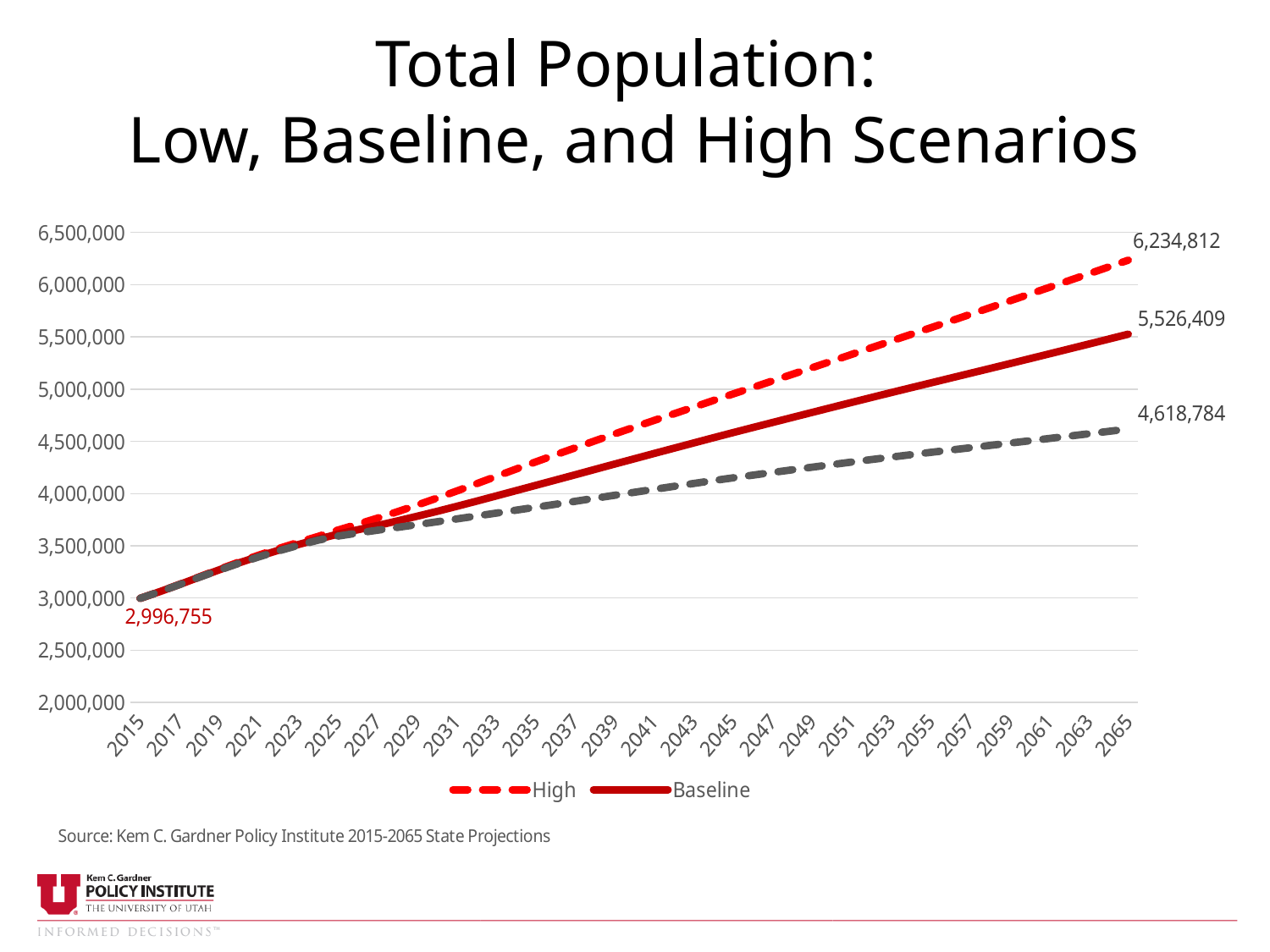
What is the difference between the High and Baseline values in 2065? 708,403 By how much does the High scenario grow from its 2015 value to its 2065 value? 3,238,057 What is the value of the High scenario in 2065? 6,234,812 How much higher is the Baseline 2065 value than the lowest line's 2065 value of 4,618,784? 907,625 What is the population value labelled at the start of the lines in 2015? 2,996,755 What kind of chart is shown on the slide? line chart What is the 2065 value labelled on the lowest (gray dashed) line? 4,618,784 How many series does the legend list? 2 Do the lines rise or fall from 2015 to 2065? rise Which scenario has the larger value in 2065, High or Baseline? High Is the value of the High scenario in 2055 greater or less than 5,000,000? greater What is the value of the Baseline scenario in 2065? 5,526,409